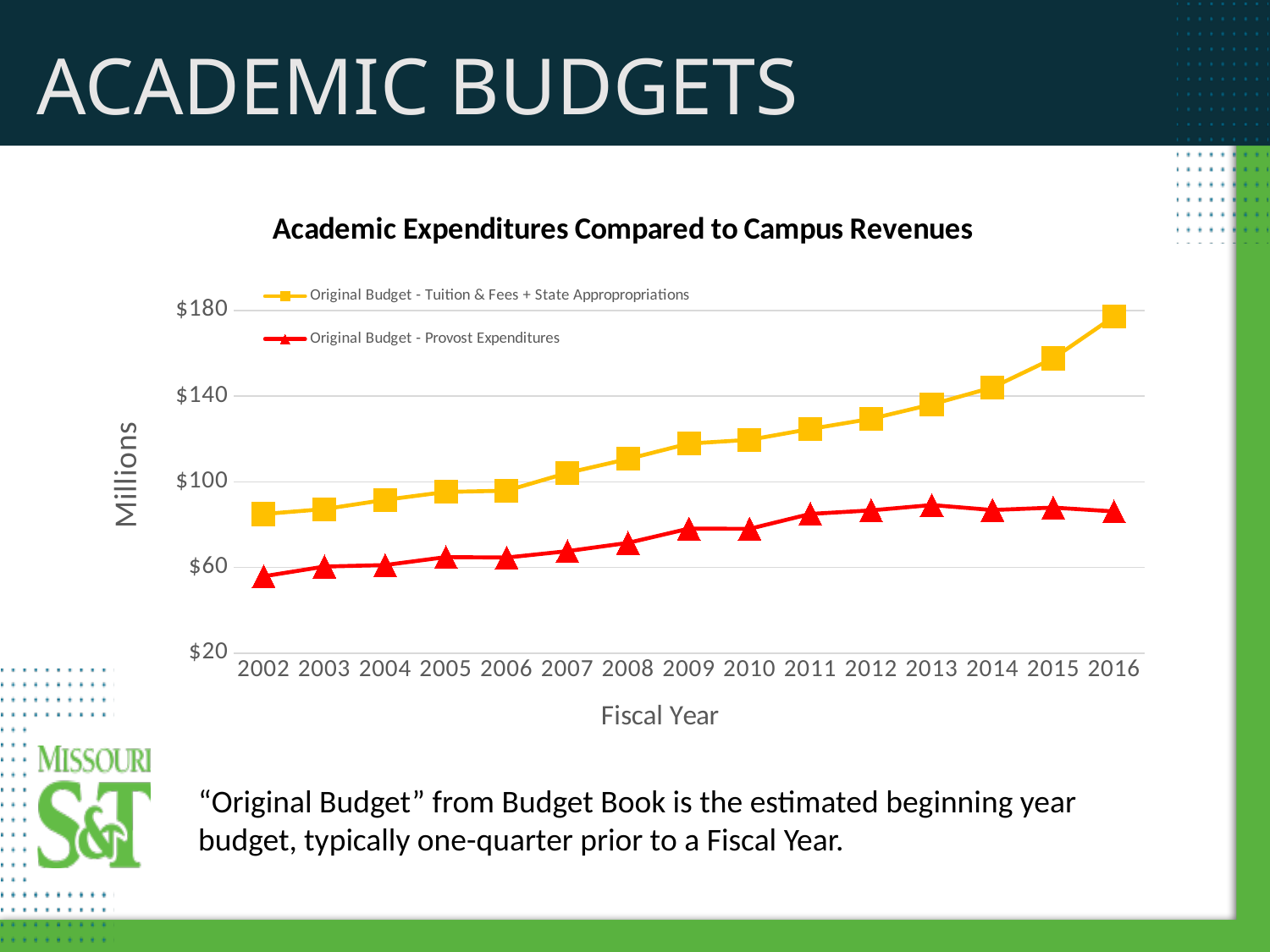
In which fiscal year is the Original Budget - Tuition & Fees + State Appropriations value highest? 2016 How many series does the chart's legend list? 2 What kind of chart is shown on the slide? line chart Does the Original Budget - Tuition & Fees + State Appropriations series generally rise or fall from 2002 to 2016? rise How many fiscal years are plotted along the x axis? 15 Is the Original Budget - Tuition & Fees + State Appropriations value for 2015 greater or less than $140? greater In 2010, which series has the larger value: Tuition & Fees + State Appropriations or Provost Expenditures? Tuition & Fees + State Appropriations Is the Original Budget - Provost Expenditures value for 2016 greater or less than $100? less Is the Original Budget - Tuition & Fees + State Appropriations value for 2002 greater or less than $100? less What is the title of the chart? Academic Expenditures Compared to Campus Revenues Which series is drawn in red with triangle markers? Original Budget - Provost Expenditures In which fiscal year is the Original Budget - Provost Expenditures value lowest? 2002